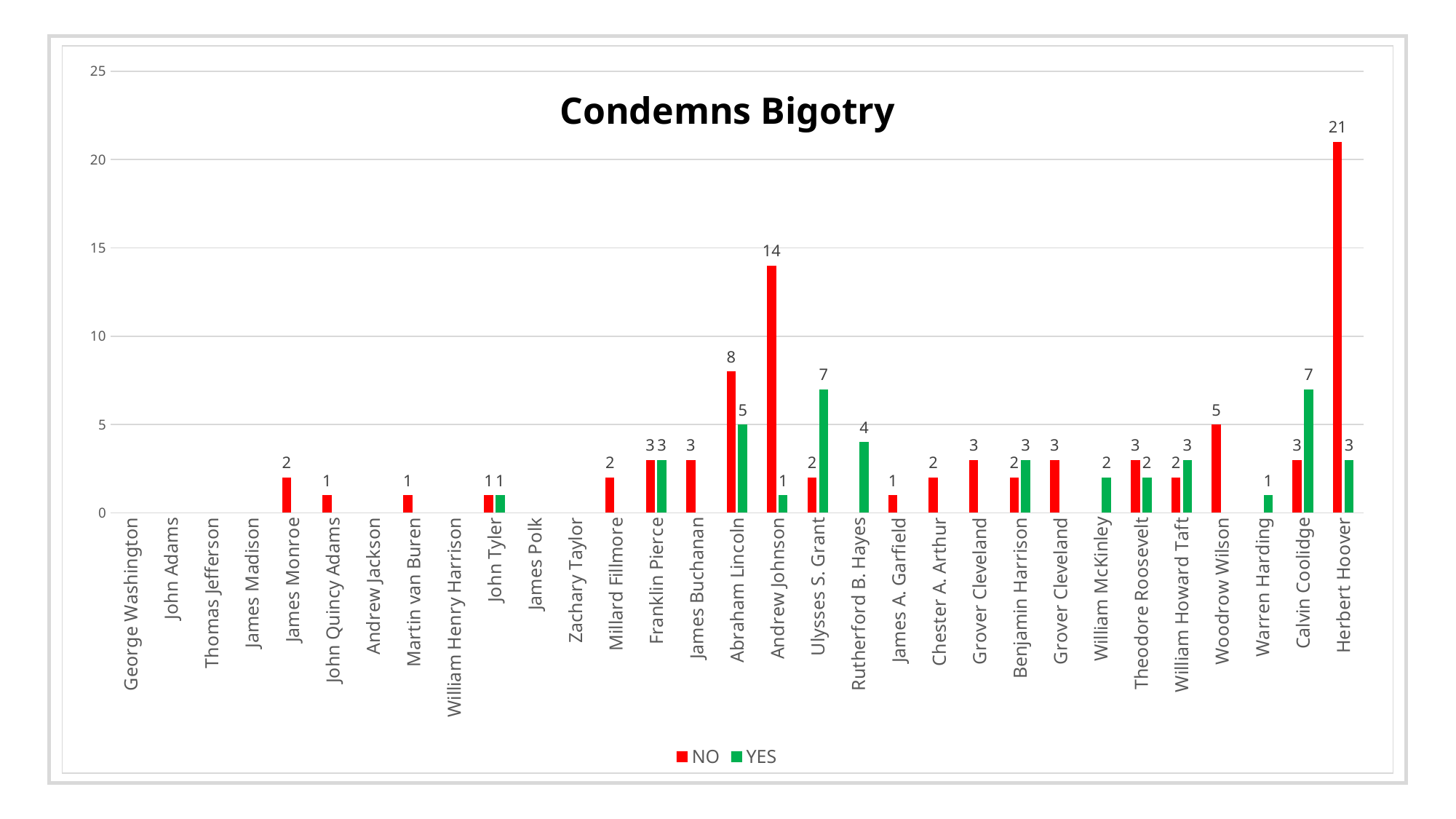
What kind of chart is shown on the slide? Bar chart Which is larger for Calvin Coolidge, the NO value or the YES value? YES What is the NO value for Woodrow Wilson? 5 How many series does the legend list? 2 What is the YES value for Ulysses S. Grant? 7 Which president has the highest NO value? Herbert Hoover Is the NO value for Herbert Hoover greater or less than 20? greater What is the NO value for Andrew Johnson? 14 What is the title of the chart? Condemns Bigotry What is the YES value for Rutherford B. Hayes? 4 What is the difference between the NO and YES values for Abraham Lincoln? 3 What is the NO value for Herbert Hoover? 21